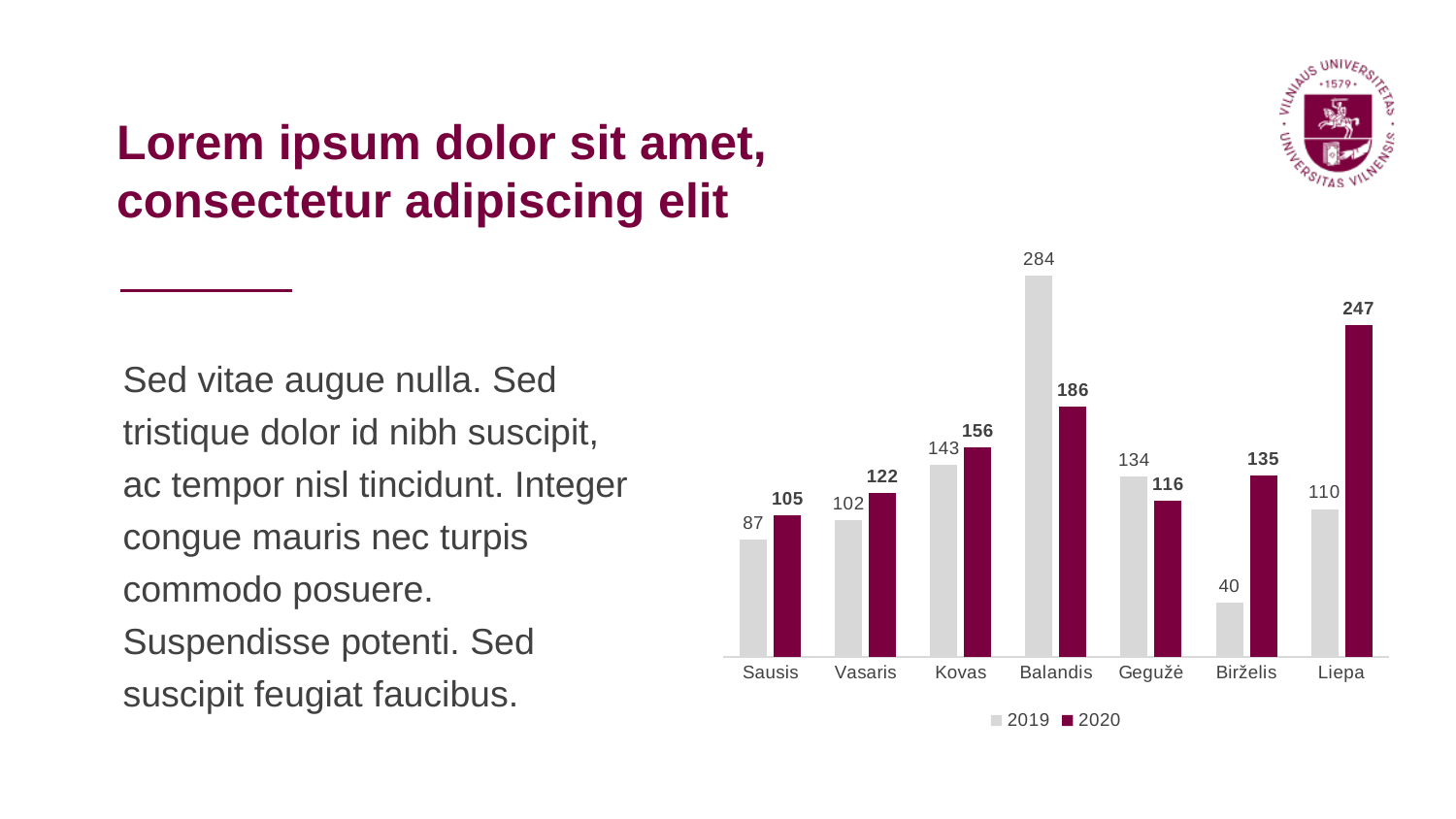
What is the 2019 value for Birželis? 40 What is the 2019 value for Balandis? 284 What is the difference between the 2020 values for Liepa and Sausis? 142 Which category has the lowest 2019 value? Birželis What is the difference between the 2019 and 2020 values for Balandis? 98 For Gegužė, which series has the larger value, 2019 or 2020? 2019 How many series does the legend list? 2 How many categories are shown on the x axis? 7 What kind of chart is shown on the slide? Bar chart What is the 2020 value for Liepa? 247 For Kovas, which series has the larger value, 2019 or 2020? 2020 Which category has the highest 2020 value? Liepa